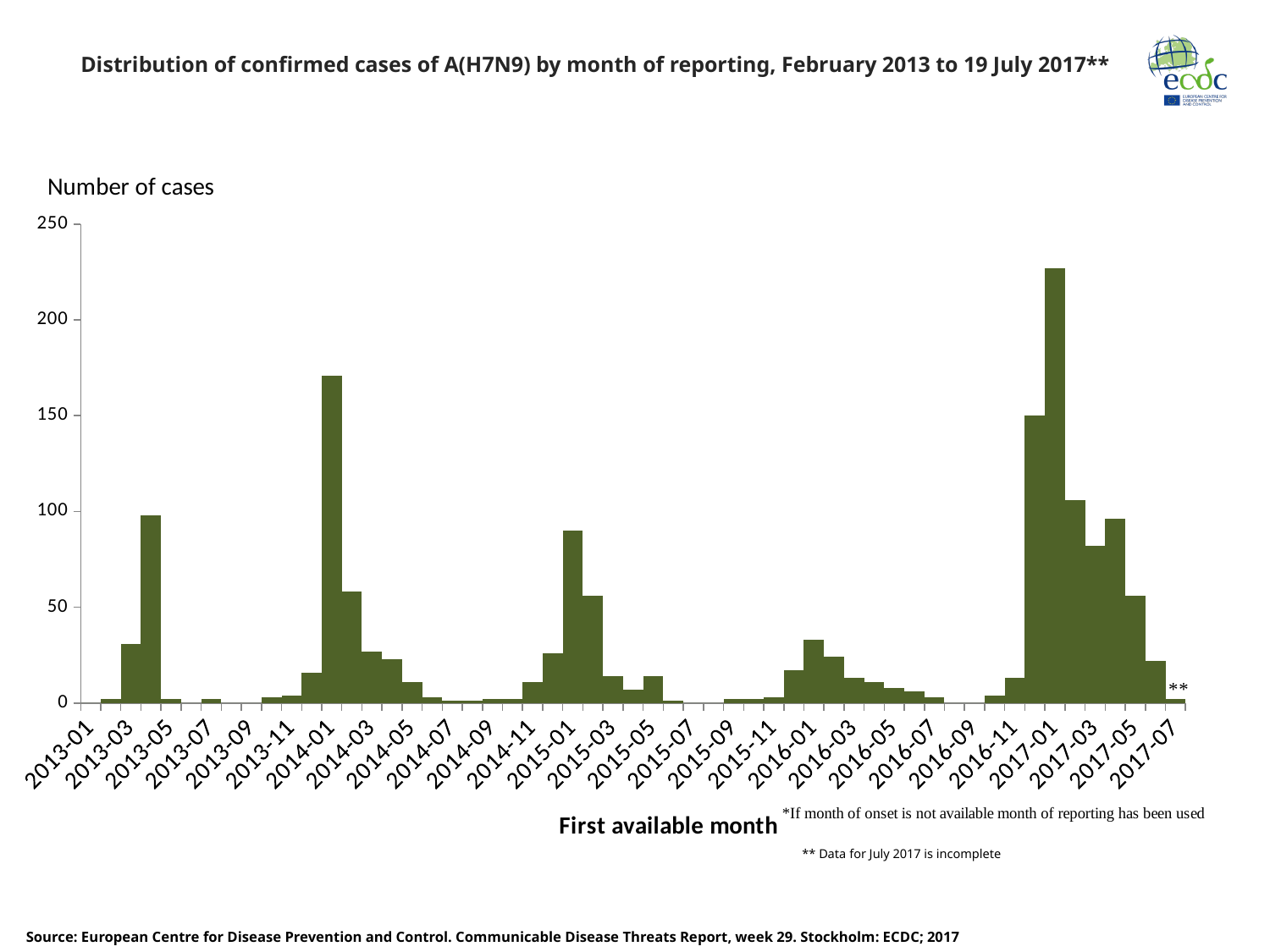
Which has more cases, 2014-01 or 2015-01? 2014-01 What kind of chart is shown on the slide? bar chart Is the value for 2017-03 greater or less than 100? less What is the title of the x axis? First available month Is the value for 2015-01 greater or less than 100? less Is the value for 2014-01 greater or less than 150? greater Which has more cases, 2013-05 or 2016-01? 2016-01 Between 2017-05 and 2017-07, do the values rise or fall? fall In which year does the tallest bar on the chart occur? 2017